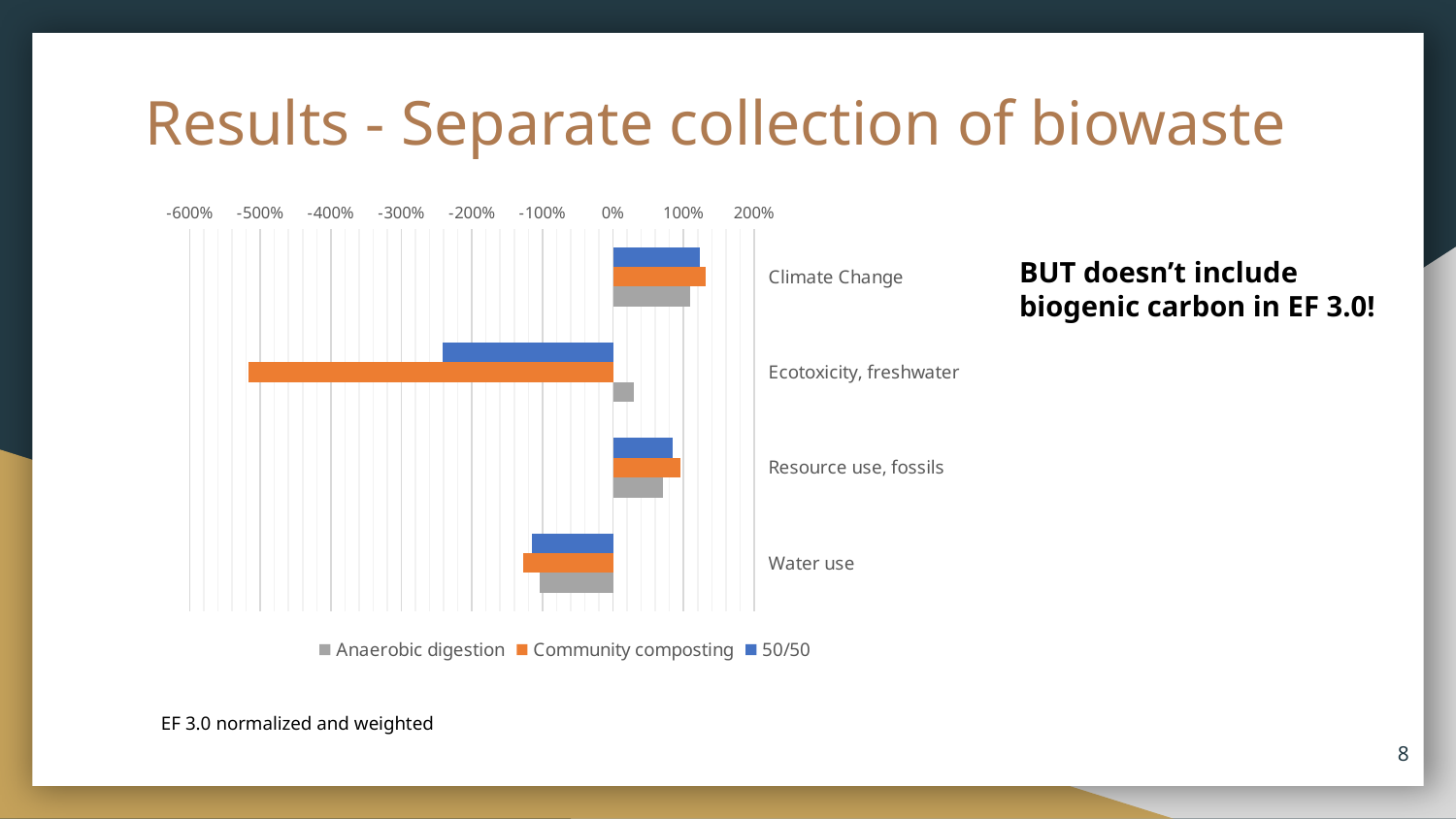
Is the value for Community composting in Climate Change greater or less than 100%? greater What kind of chart is shown on the slide? bar chart What note appears below the chart legend describing the method? EF 3.0 normalized and weighted Is the value for 50/50 in Ecotoxicity, freshwater greater or less than -200%? less Is the value for Community composting in Water use greater or less than -100%? less Which series are listed in the chart legend? Anaerobic digestion, Community composting, 50/50 For Ecotoxicity, freshwater, which series has the highest value? Anaerobic digestion Which category has the lowest value for Community composting? Ecotoxicity, freshwater How many series does the chart legend list? 3 For Ecotoxicity, freshwater, which is larger: the value for 50/50 or the value for Community composting? 50/50 How many impact categories are plotted on the chart? 4